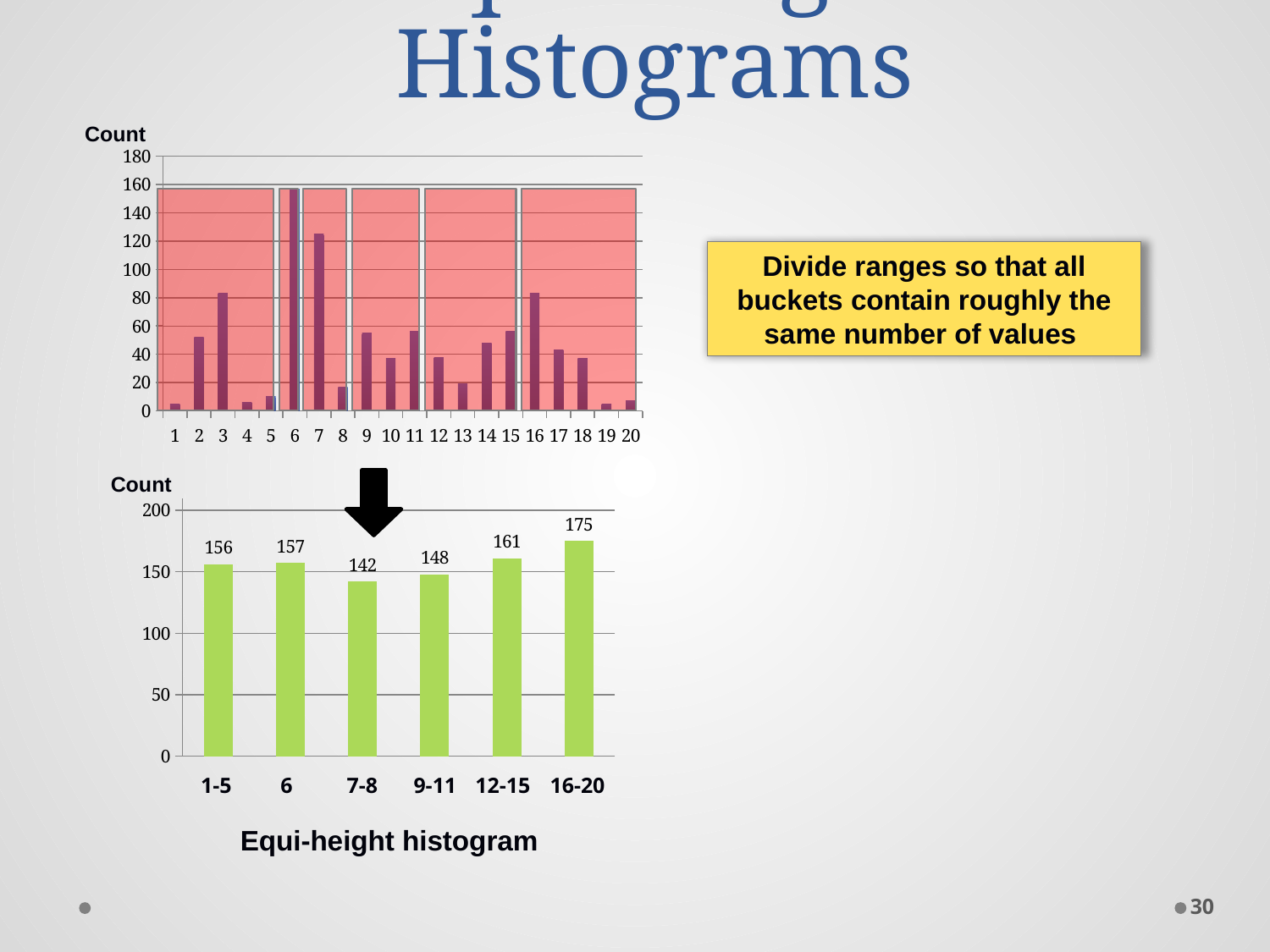
How many categories are shown on the x axis of the top chart? 20 In the bottom chart (Equi-height histogram), which bucket has the lowest count? 7-8 In the top chart, is the value for category 6 greater or less than 140? greater In the top chart, is the value for category 1 greater or less than 20? less In the bottom chart (Equi-height histogram), which is larger, the value for 1-5 or the value for 12-15? 12-15 In the bottom chart (Equi-height histogram), what is the difference between the 16-20 bucket and the 7-8 bucket? 33 In the bottom chart (Equi-height histogram), what is the value for the 16-20 bucket? 175 In the bottom chart (Equi-height histogram), what is the value for the 9-11 bucket? 148 In the bottom chart (Equi-height histogram), what is the value for the 7-8 bucket? 142 In the bottom chart (Equi-height histogram), which bucket has the highest count? 16-20 How many buckets are shown in the bottom chart (Equi-height histogram)? 6 What kind of chart is the bottom chart (Equi-height histogram)? bar chart